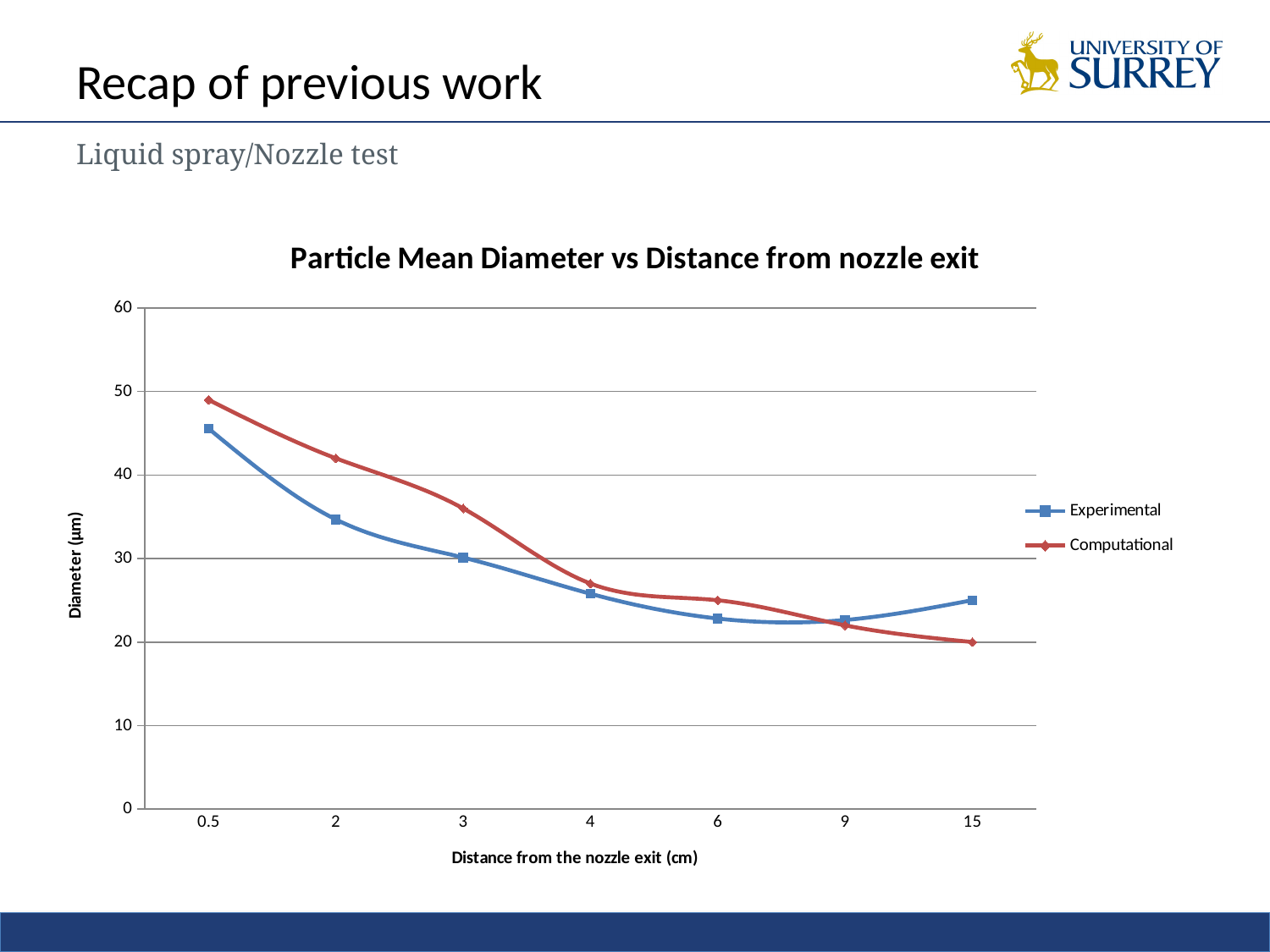
Is the Experimental value at 0.5 cm greater or less than 40? greater What kind of chart is shown on the slide? line chart Does the Computational series rise or fall as distance from the nozzle exit increases? fall How many distance values are plotted along the x axis? 7 At which distance from the nozzle exit is the Computational diameter lowest? 15 At which distance from the nozzle exit is the Computational diameter highest? 0.5 Is the Experimental value at 6 cm greater or less than 30? less Is the Computational value at 2 cm greater or less than 40? greater At 0.5 cm, which series has the larger diameter, Experimental or Computational? Computational What is the title of the chart? Particle Mean Diameter vs Distance from nozzle exit How many series does the legend list? 2 At 15 cm, which series has the larger diameter, Experimental or Computational? Experimental